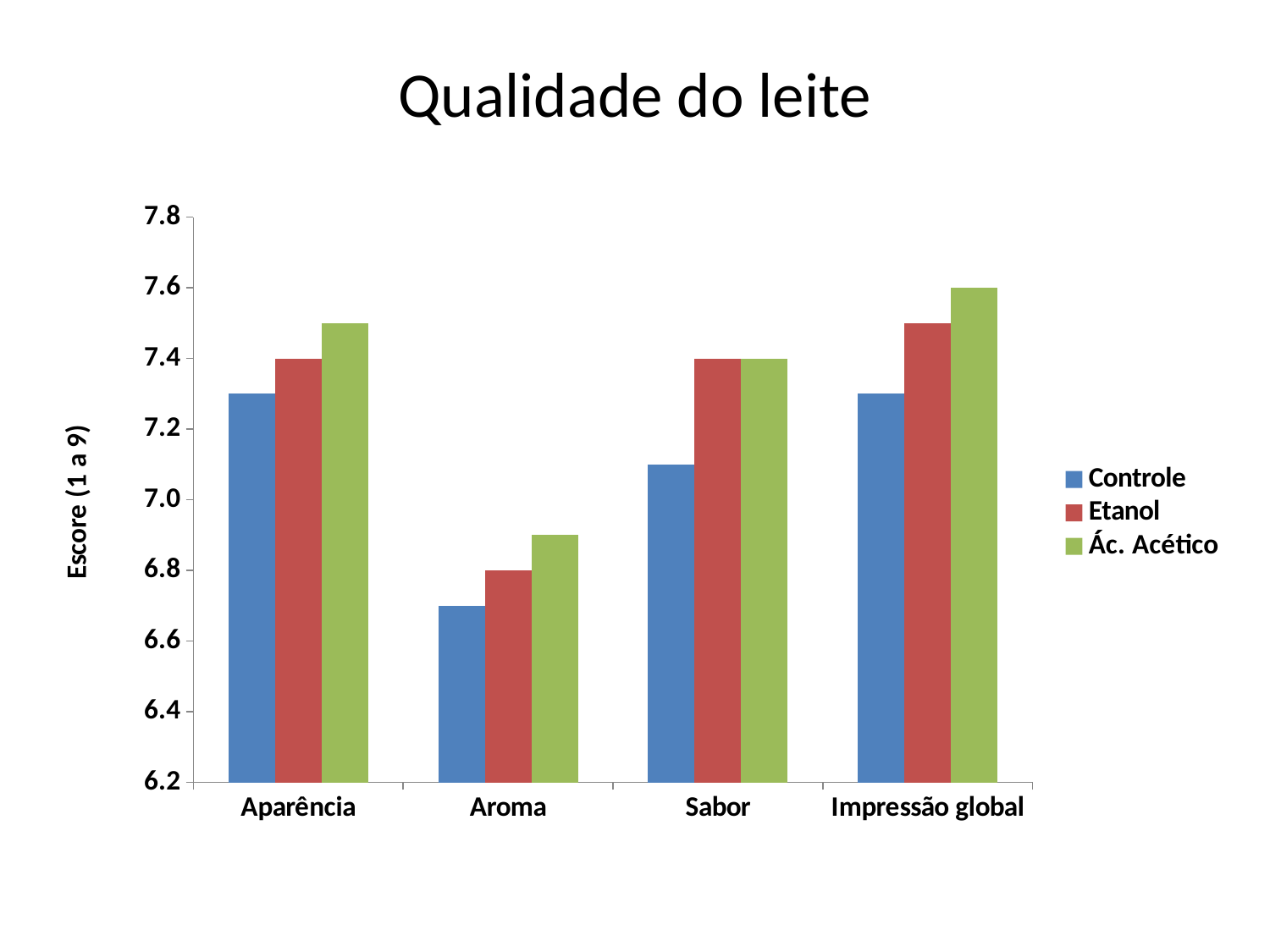
What kind of chart is shown on the slide? bar chart What is the Ác. Acético score for Impressão global? 7.6 Is the Controle value for Sabor greater or less than 7.2? less What is the Etanol score for Sabor? 7.4 Is the Controle value for Aroma greater or less than 6.8? less Which is larger for Aroma, the Controle score or the Ác. Acético score? Ác. Acético Is the Ác. Acético value for Aparência greater or less than 7.4? greater What is the Etanol score for Aparência? 7.4 How many series does the legend list? 3 How many categories are shown on the x axis? 4 Which category has the lowest Controle score? Aroma Which category has the highest Ác. Acético score? Impressão global